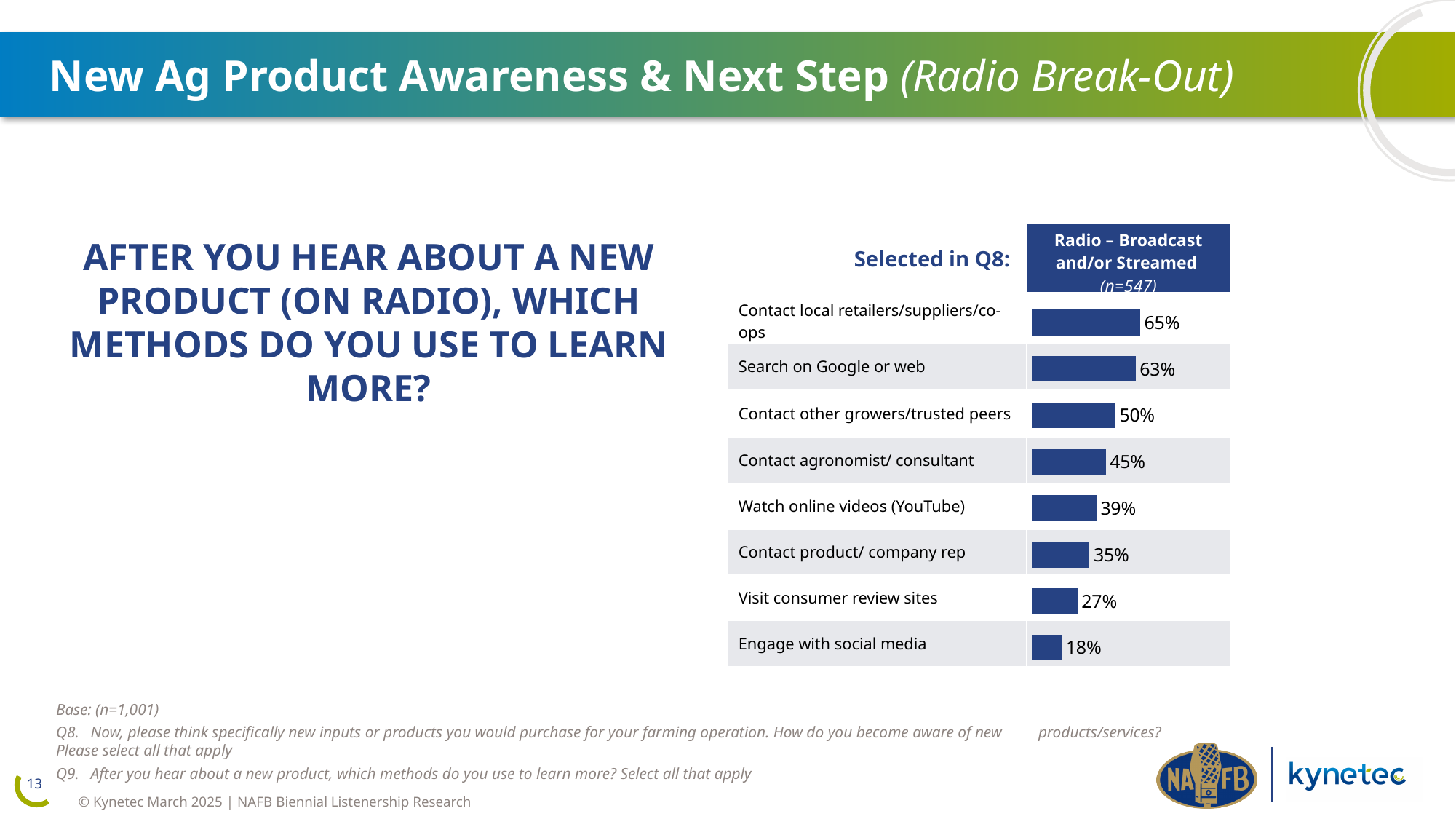
What is the value for 'Engage with social media'? 18% How many methods are shown in the chart? 8 What is the sample size (n) shown in the column header of the chart? n=547 What percentage of respondents said they contact local retailers/suppliers/co-ops to learn more about a new product? 65% What kind of chart is shown on the slide? Bar chart Which method has the lowest percentage? Engage with social media What is the value for 'Search on Google or web'? 63% What percentage of respondents watch online videos (YouTube) to learn more? 39% What is the difference between 'Contact other growers/trusted peers' and 'Contact agronomist/ consultant'? 5% What is the difference between 'Contact product/ company rep' and 'Visit consumer review sites'? 8% Which method has the highest percentage? Contact local retailers/suppliers/co-ops Which is larger: 'Watch online videos (YouTube)' or 'Contact product/ company rep'? Watch online videos (YouTube)